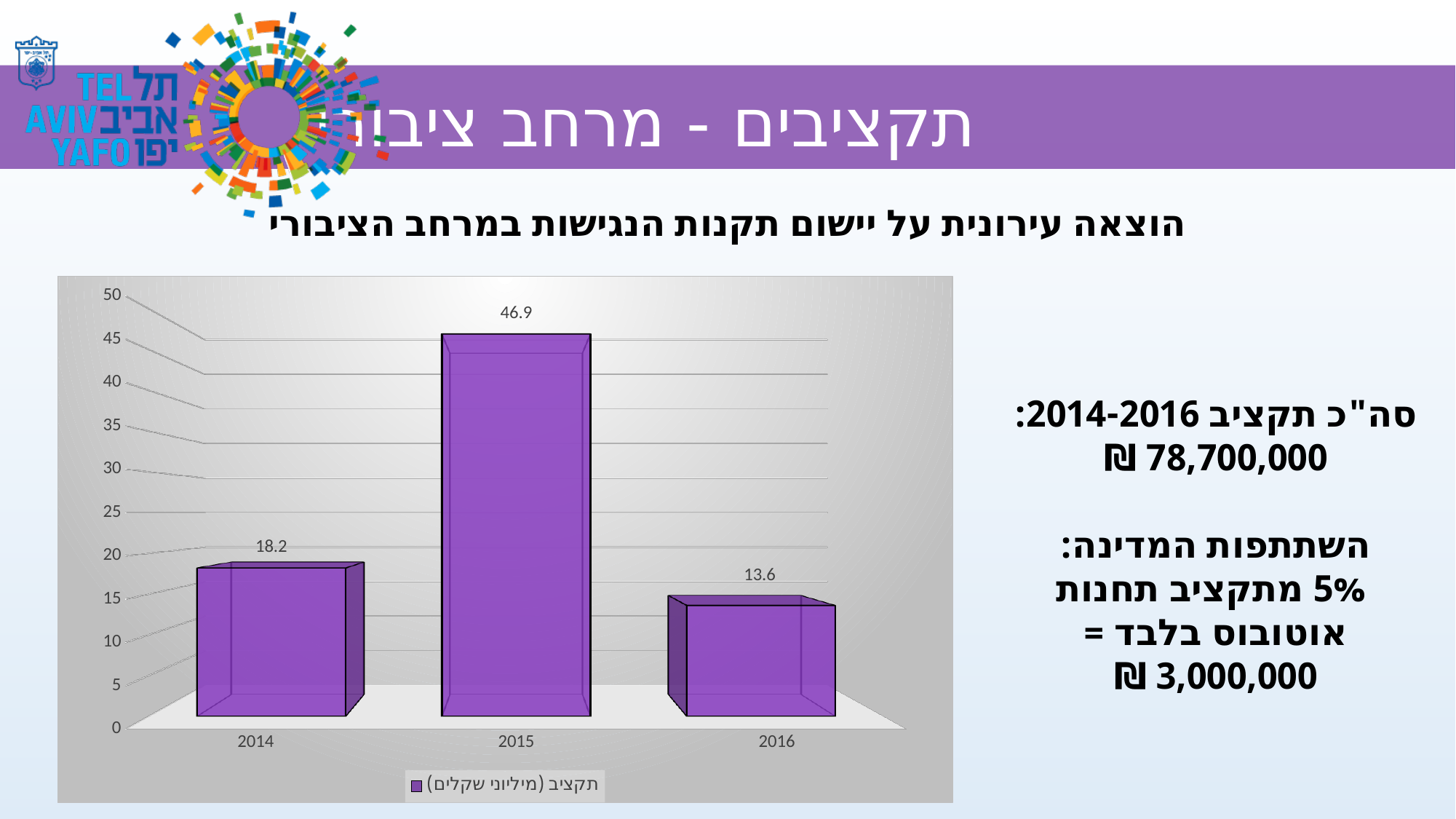
Which is larger, the value for 2014 or the value for 2016? 2014 What is the difference between the values for 2015 and 2014? 28.7 What kind of chart is shown on the slide? bar chart Is the value for 2015 greater or less than 45? greater How many years are shown on the x axis? 3 What is the value for 2014? 18.2 Which year has the highest value? 2015 What is the difference between the values for 2014 and 2016? 4.6 What is the value for 2015? 46.9 What is the value for 2016? 13.6 How many series does the legend list? 1 Which year has the lowest value? 2016